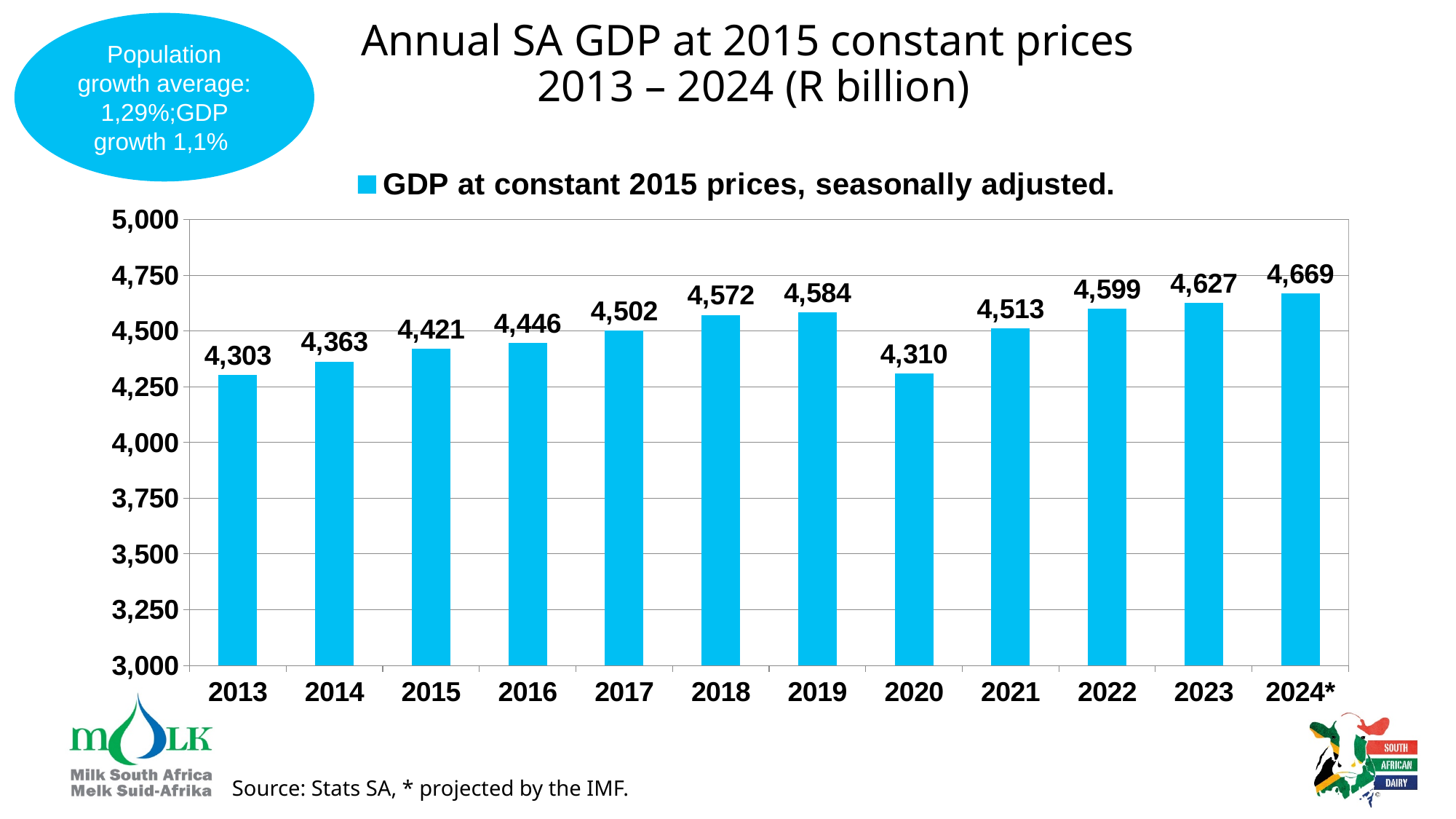
What is the GDP value shown for 2017? 4,502 How many years are shown on the x axis? 12 What is the difference between the GDP values for 2024* and 2013? 366 What kind of chart is shown on the slide? bar chart What is the legend entry for the series shown? GDP at constant 2015 prices, seasonally adjusted. Which year has the lowest GDP value on the chart? 2013 Is the value for 2018 greater or less than 4,500? greater Which is larger, the GDP value for 2016 or for 2021? 2021 How many series does the legend list? 1 What is the difference between the GDP values for 2019 and 2020? 274 What is the GDP value shown for 2020? 4,310 Which year has the highest GDP value on the chart? 2024*